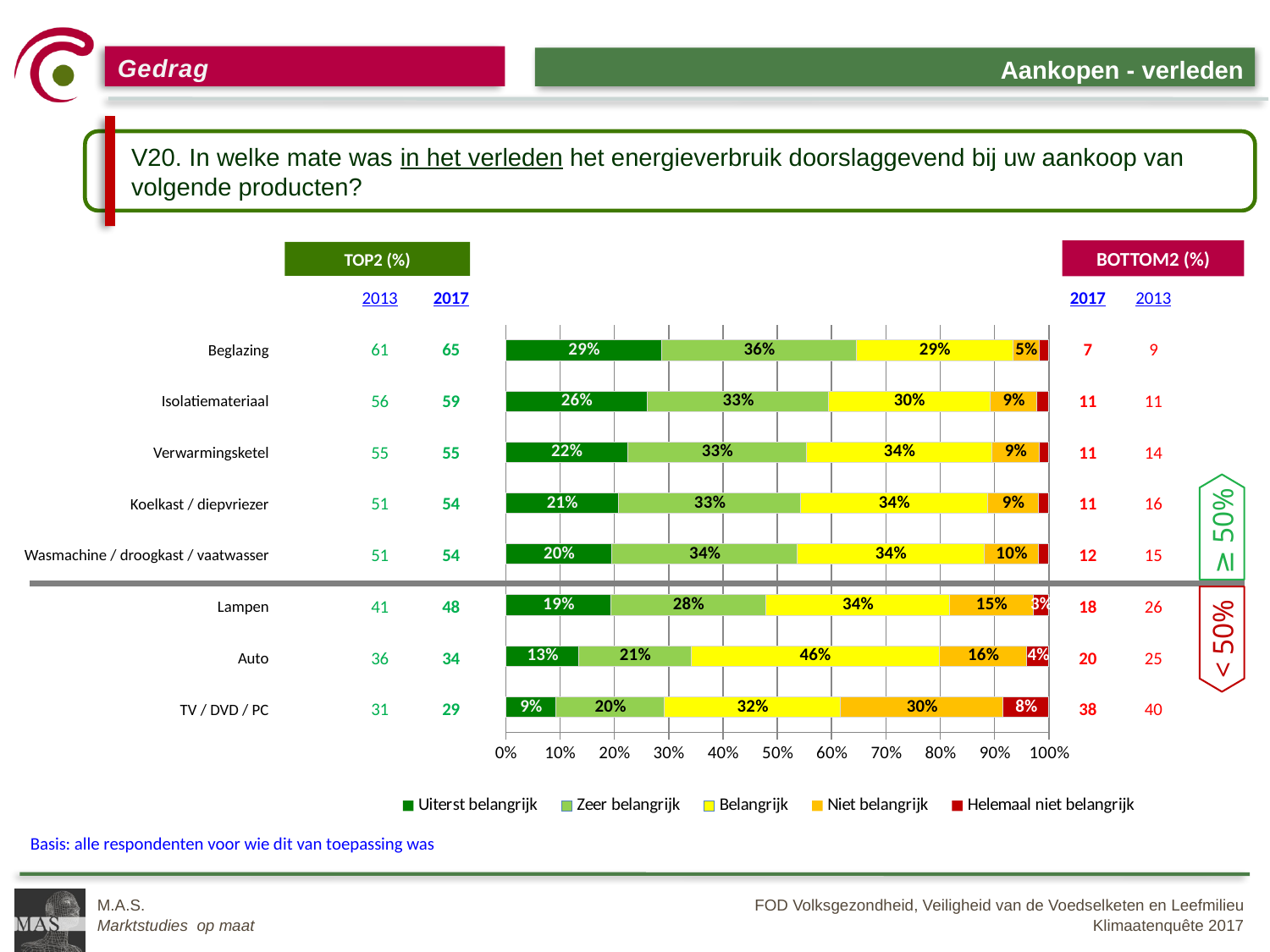
What is the difference in the 'Niet belangrijk' share between TV / DVD / PC and Lampen? 15 percentage points What type of chart is used to show the importance ratings? Stacked bar chart Which product has the lowest 'Uiterst belangrijk' share? TV / DVD / PC What percentage of respondents rated energy consumption as 'Uiterst belangrijk' for Beglazing? 29% What is the 'Belangrijk' share for Auto? 46% How many products are shown in the stacked bar chart? 8 What is the 'Helemaal niet belangrijk' share for TV / DVD / PC? 8% What is the first entry in the chart legend? Uiterst belangrijk Which has a larger 'Zeer belangrijk' share, Beglazing or Lampen? Beglazing Which product has the highest 'Niet belangrijk' share? TV / DVD / PC Which product has the highest 'Uiterst belangrijk' share? Beglazing How many series does the legend list? 5